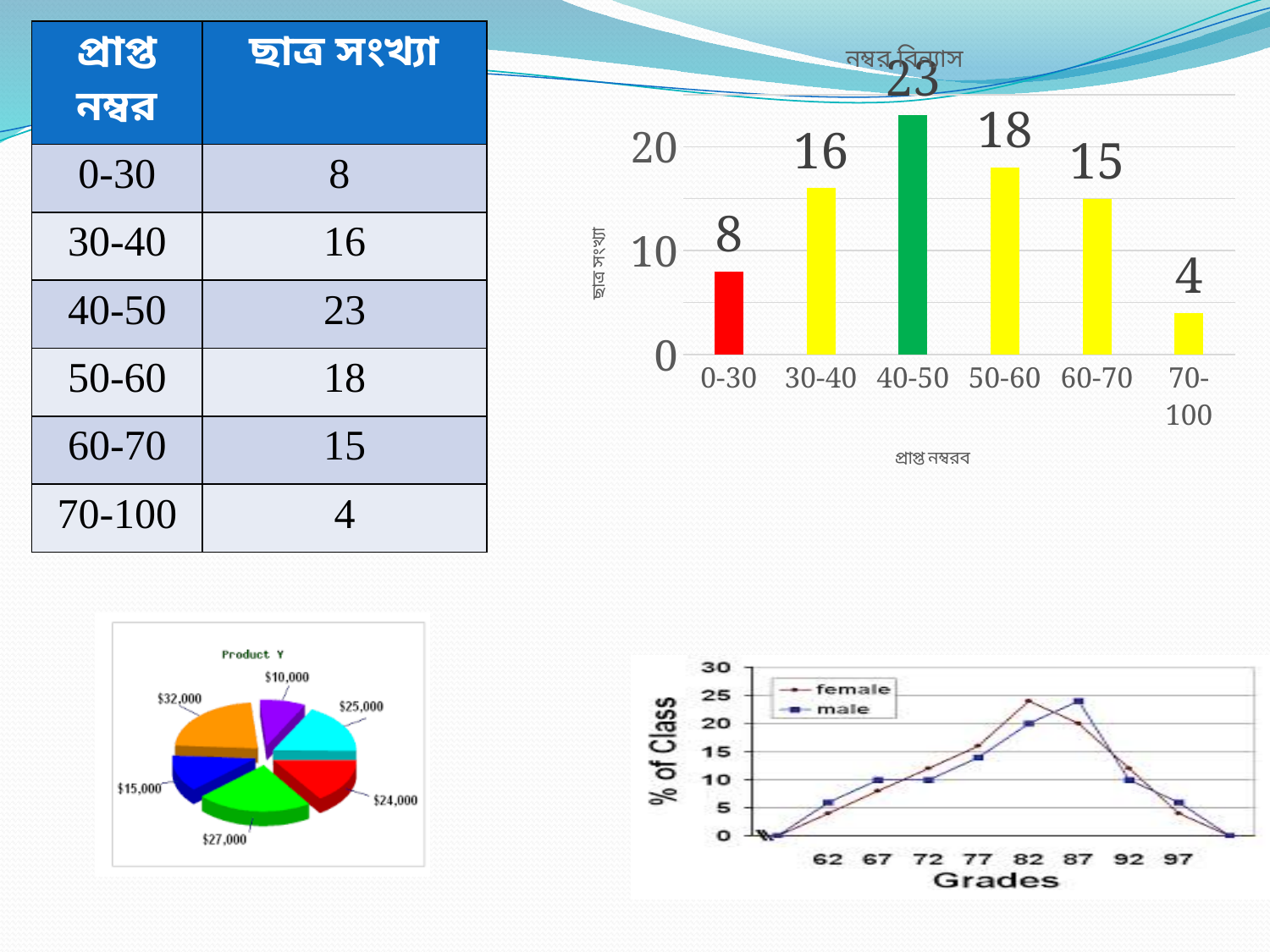
In the bar chart at the top right, what is the value for the 70-100 category? 4 In the bar chart at the top right, how many students scored in the 40-50 range? 23 In the bar chart at the top right, which is larger: the value for 30-40 or the value for 60-70? 30-40 In the bar chart at the top right, which category has the lowest value? 70-100 In the line chart at the bottom right, how many series does the legend list? 2 What kind of chart is the chart at the top right of the slide? bar chart In the Product Y pie chart, how many slices are there? 6 In the Product Y pie chart, which slice has the largest value? $32,000 In the bar chart at the top right, how many categories are shown on the x axis? 6 In the bar chart at the top right, what is the difference between the values for 50-60 and 60-70? 3 In the line chart at the bottom right, is the female value at grade 82 greater or less than 20? greater In the bar chart at the top right, which category has the highest value? 40-50